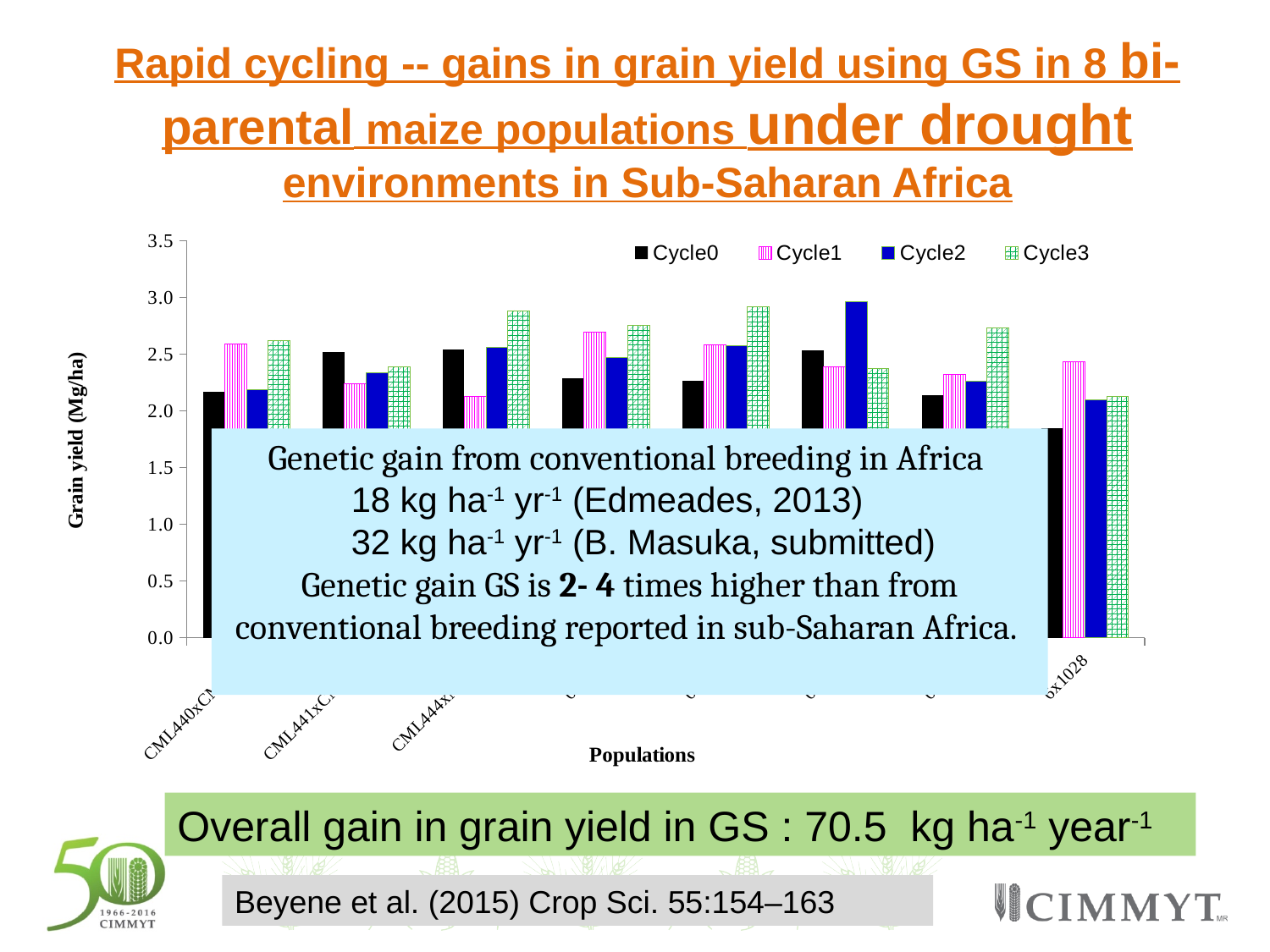
For the first population (CML440x...), which is larger, the Cycle0 value or the Cycle1 value? Cycle1 What is the title of the vertical axis of the chart? Grain yield (Mg/ha) Is the Cycle1 value for the second population (CML441x...) greater or less than 2.5? less For the third population (CML444x...), which cycle has the highest grain yield? Cycle3 Is the Cycle3 value for the third population (CML444x...) greater or less than 2.5? greater What is the title of the horizontal axis of the chart? Populations Is the Cycle0 value for the last population (...x1028) greater or less than 2.0? less How many series does the chart legend list? 4 What kind of chart is shown on the slide? bar chart How many population groups are plotted along the x axis of the chart? 8